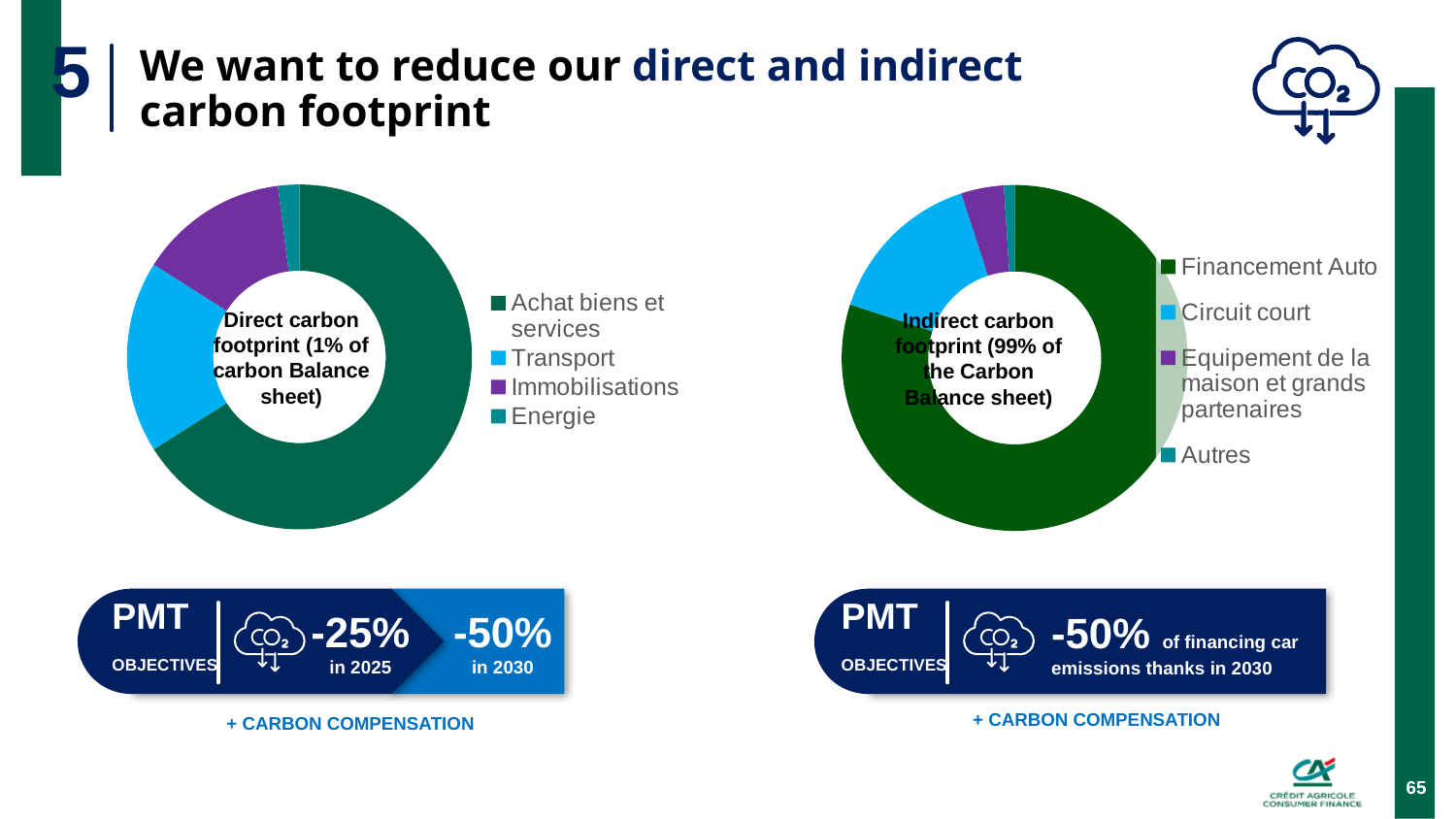
In the 'Direct carbon footprint' chart, which slice is larger: Transport or Immobilisations? Transport In the 'Direct carbon footprint' chart, which category has the largest slice? Achat biens et services In the 'Direct carbon footprint' chart, which category has the smallest slice? Energie According to the centre label of the right chart, what share of the carbon balance sheet does the indirect carbon footprint represent? 99% In the 'Indirect carbon footprint' chart, how many categories does the legend list? 4 In the 'Direct carbon footprint' chart, how many categories does the legend list? 4 What kind of chart is the 'Indirect carbon footprint' chart on the right? Pie chart (donut) According to the centre label of the left chart, what share of the carbon balance sheet does the direct carbon footprint represent? 1% In the 'Indirect carbon footprint' chart, which slice is larger: Circuit court or Equipement de la maison et grands partenaires? Circuit court In the 'Indirect carbon footprint' chart, which category has the largest slice? Financement Auto In the 'Indirect carbon footprint' chart, which category has the smallest slice? Autres What kind of chart is the 'Direct carbon footprint' chart on the left? Pie chart (donut)